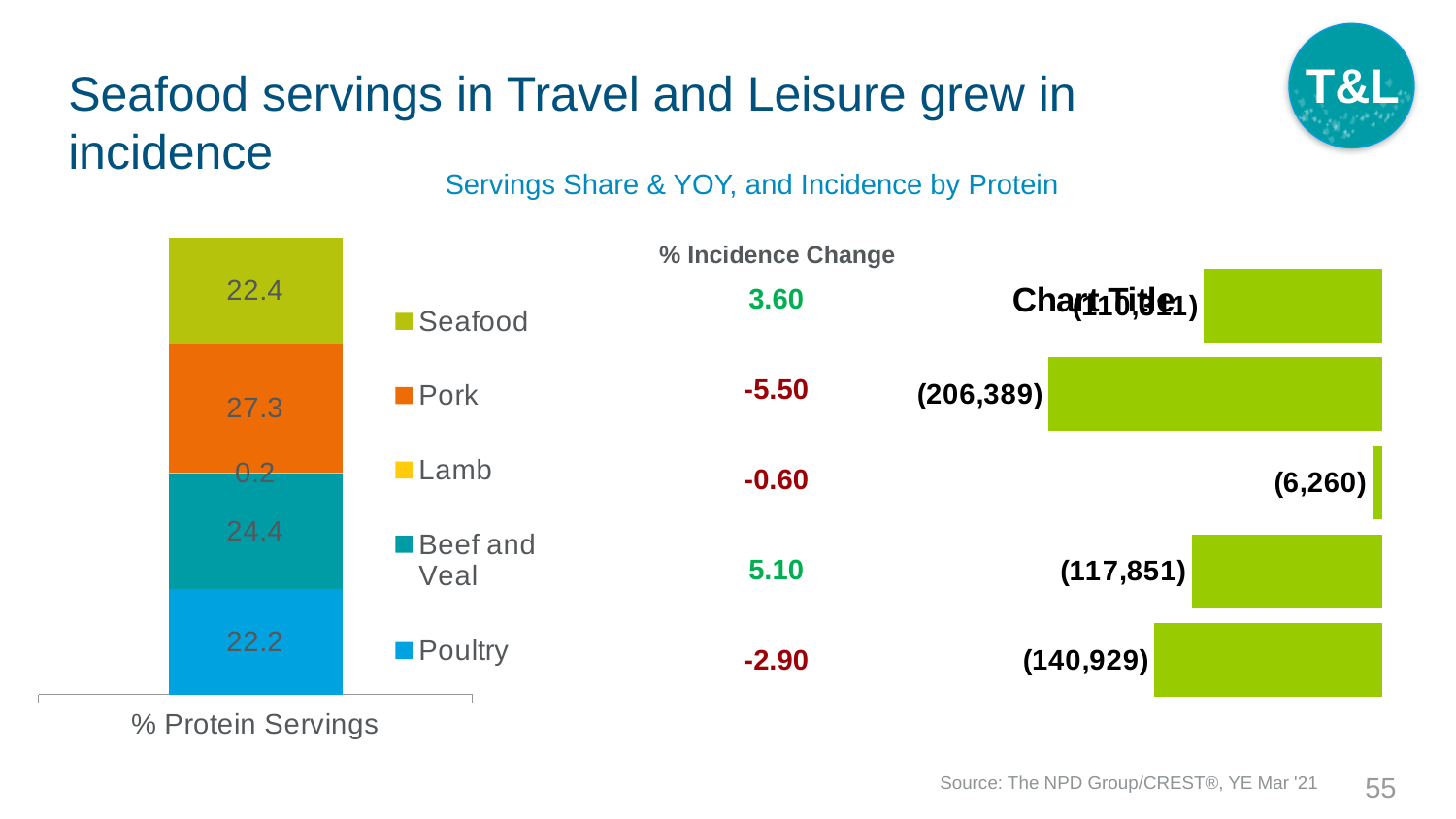
What kind of chart is the % Protein Servings chart on the left? Stacked bar chart In the % Protein Servings stacked bar chart, which protein has the smallest segment? Lamb In the % Protein Servings stacked bar chart, what is the total of all the segments? 96.5 What is the % Incidence Change value shown for Beef and Veal? 5.10 In the % Protein Servings stacked bar chart, what is the value for Lamb? 0.2 In the bar chart on the right of the slide, which protein has the longest bar? Pork In the bar chart on the right of the slide, what is the value labelled for Lamb? (6,260) Which protein has the lowest % Incidence Change value? Pork How many proteins does the legend of the % Protein Servings chart list? 5 In the % Protein Servings stacked bar chart, which protein has the largest segment? Pork In the % Protein Servings stacked bar chart, what is the difference between the Seafood value and the Poultry value? 0.2 In the % Protein Servings stacked bar chart, what is the value for Pork? 27.3